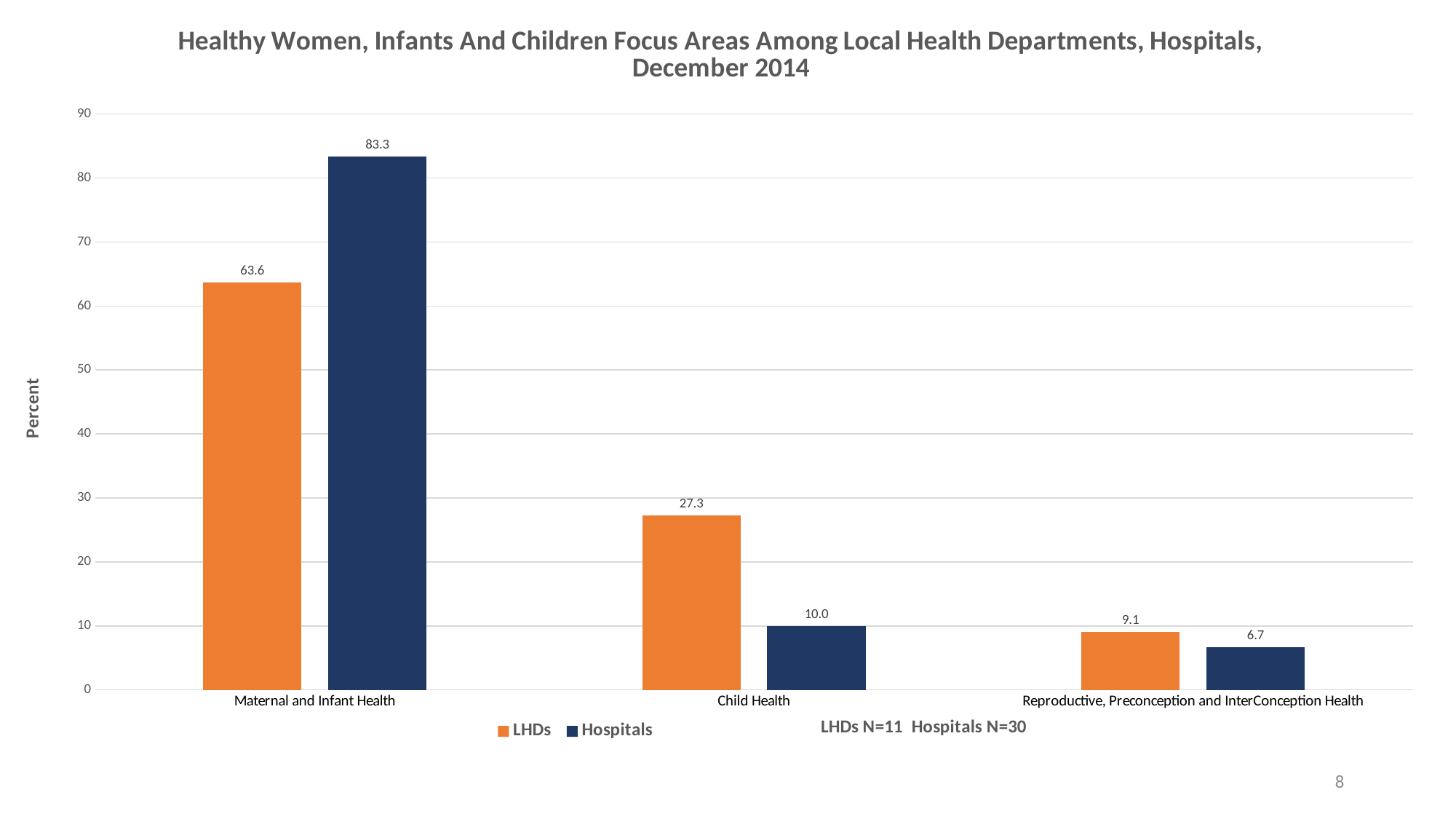
Which category has the lowest LHDs value? Reproductive, Preconception and InterConception Health What kind of chart is shown on the slide? bar chart What is the Hospitals value for Child Health? 10.0 What is the difference between the LHDs and Hospitals values for Child Health? 17.3 What is the LHDs value for Maternal and Infant Health? 63.6 For Child Health, which series has the larger value, LHDs or Hospitals? LHDs How many categories are shown on the x axis? 3 What is the Hospitals value for Reproductive, Preconception and InterConception Health? 6.7 Is the LHDs value for Child Health greater or less than 30? less Which category has the highest Hospitals value? Maternal and Infant Health What is the difference between the Hospitals and LHDs values for Maternal and Infant Health? 19.7 How many series does the legend list? 2